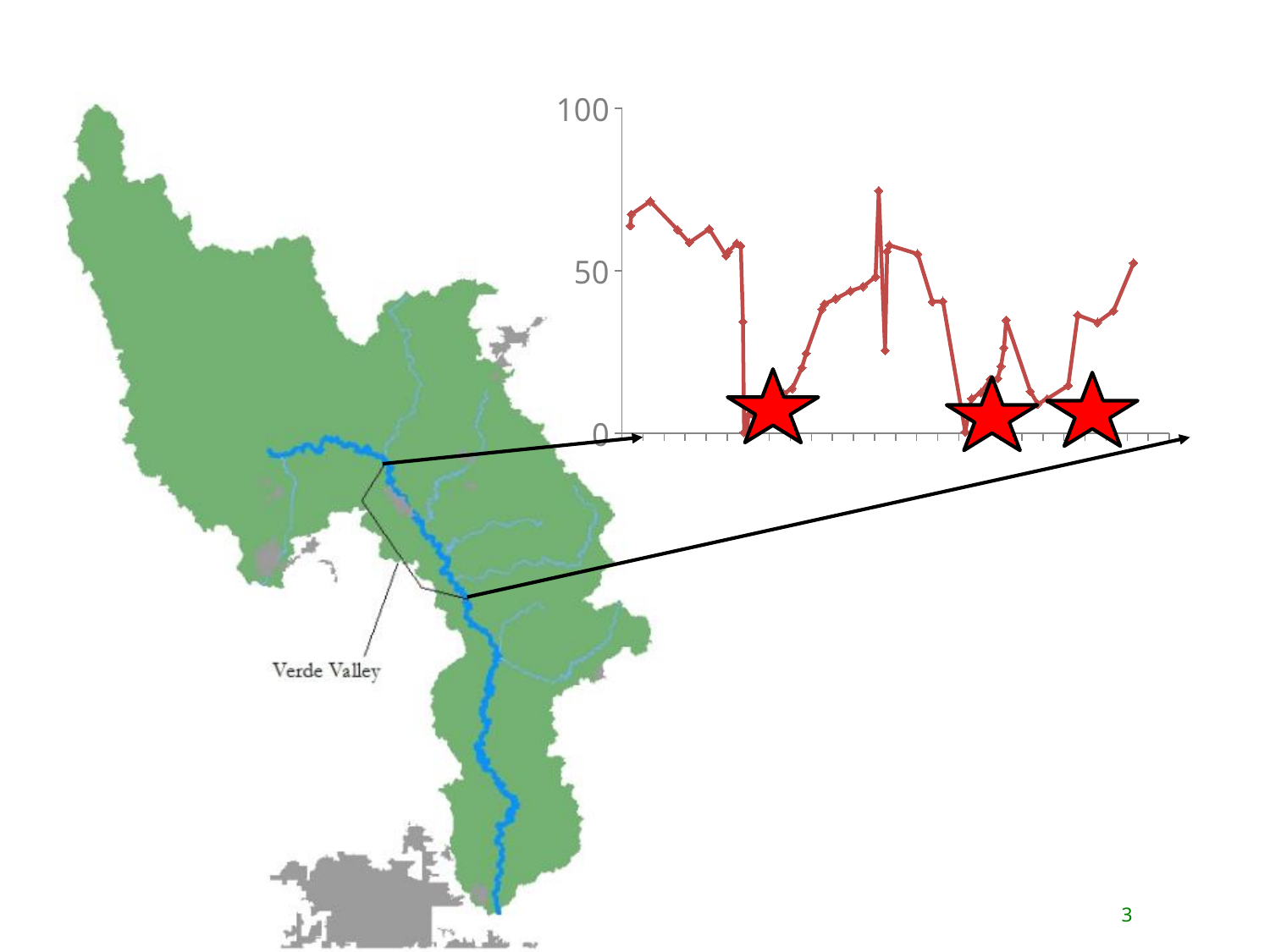
Is the lowest point on the line chart greater or less than 50? less Is the value of the first point on the line chart greater or less than 50? greater Is the highest point on the line chart greater or less than 50? greater What kind of chart is shown on the right side of the slide? line chart What colour is the line plotted on the chart? red What is the highest value labelled on the y axis of the line chart? 100 How many red stars are drawn on the line chart? 3